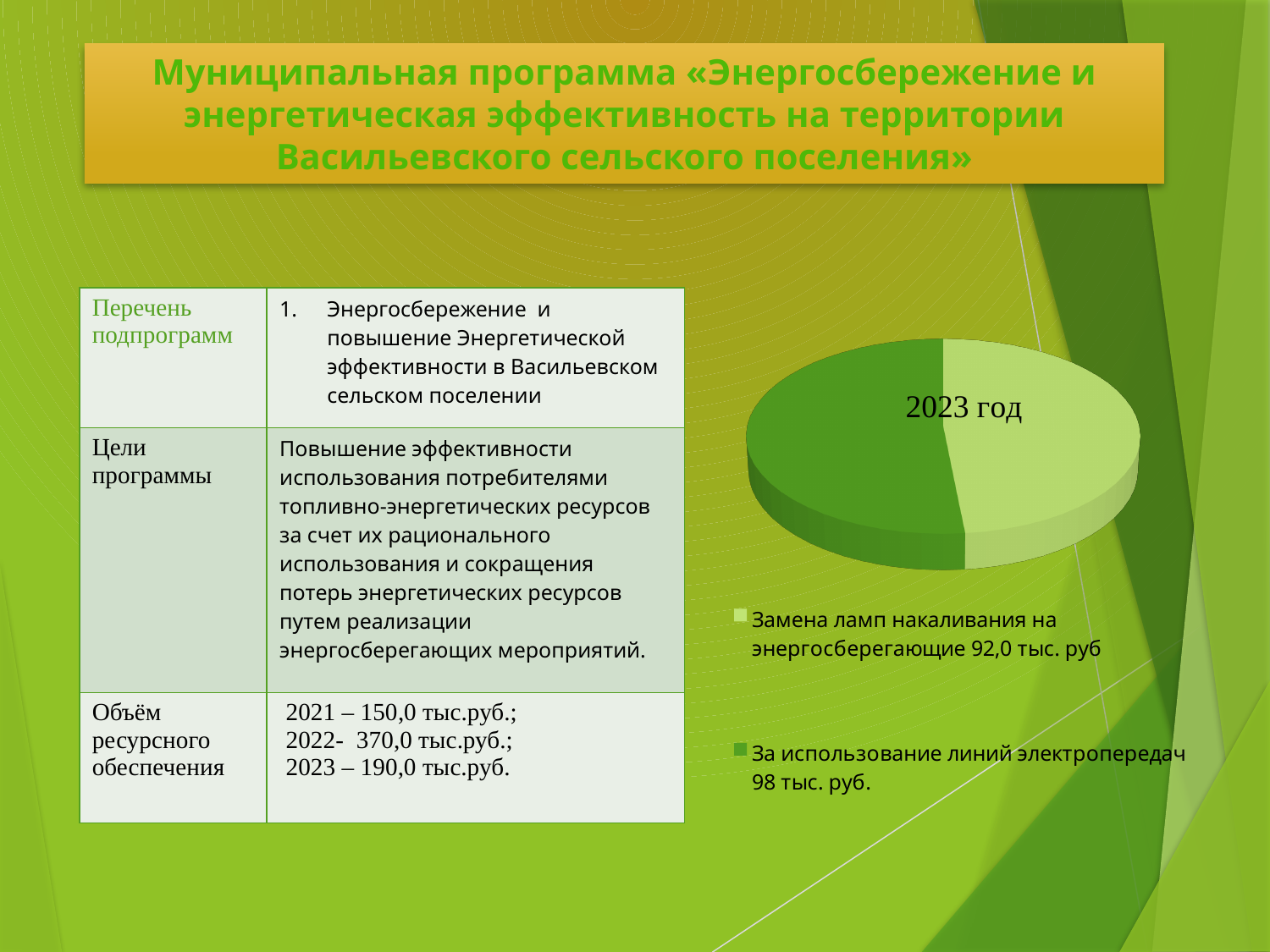
What kind of chart is shown on the slide? pie chart Is the value for «За использование линий электропередач» larger or smaller than the value for «Замена ламп накаливания на энергосберегающие»? larger Which legend entry of the pie chart is shown in the darker green colour? За использование линий электропередач 98 тыс. руб. Which category has the larger value in the pie chart? За использование линий электропередач How many entries does the legend of the pie chart list? 2 According to the legend, what is the value for «За использование линий электропередач»? 98 тыс. руб. How many slices does the pie chart have? 2 What is the title of the pie chart? 2023 год What is the total of the two values shown in the pie chart legend? 190 тыс. руб. According to the legend, what is the value for «Замена ламп накаливания на энергосберегающие»? 92,0 тыс. руб What is the difference between the value for «За использование линий электропередач» and the value for «Замена ламп накаливания на энергосберегающие»? 6 тыс. руб. Which category has the smaller value in the pie chart? Замена ламп накаливания на энергосберегающие